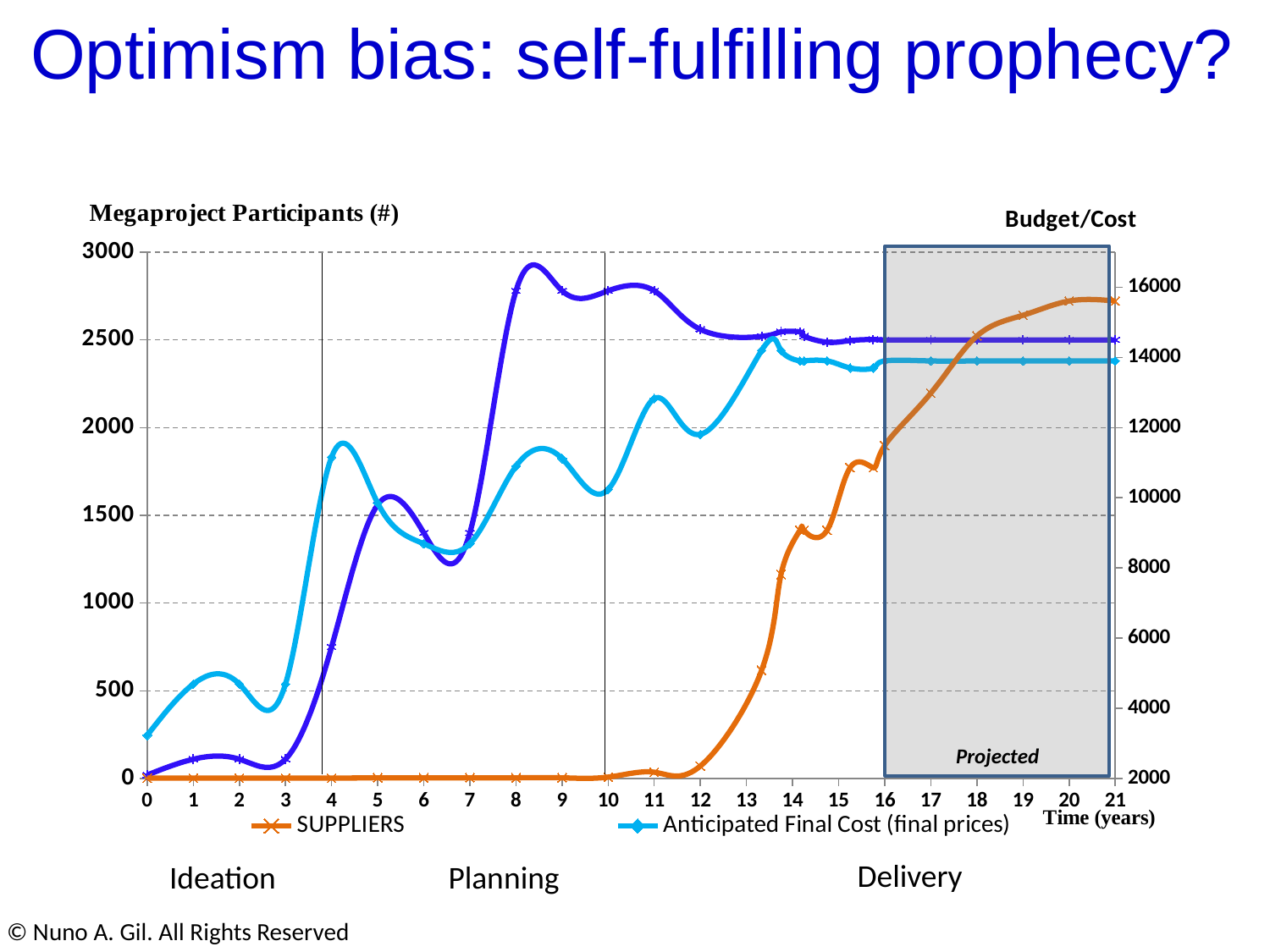
What kind of chart is shown on the slide? line chart What is the title of the left vertical axis? Megaproject Participants (#) Is the SUPPLIERS value at year 14 greater or less than 1000? greater Is the SUPPLIERS value at year 12 greater or less than 500? less How many series does the chart's legend list? 2 Is the SUPPLIERS value at year 21 greater or less than 2500? greater Which is larger for the SUPPLIERS series: the value at year 21 or the value at year 12? year 21 What label is printed inside the shaded region at the right of the chart? Projected How many year ticks are labelled on the Time (years) axis? 22 Does the SUPPLIERS series rise or fall between year 12 and year 21? rise